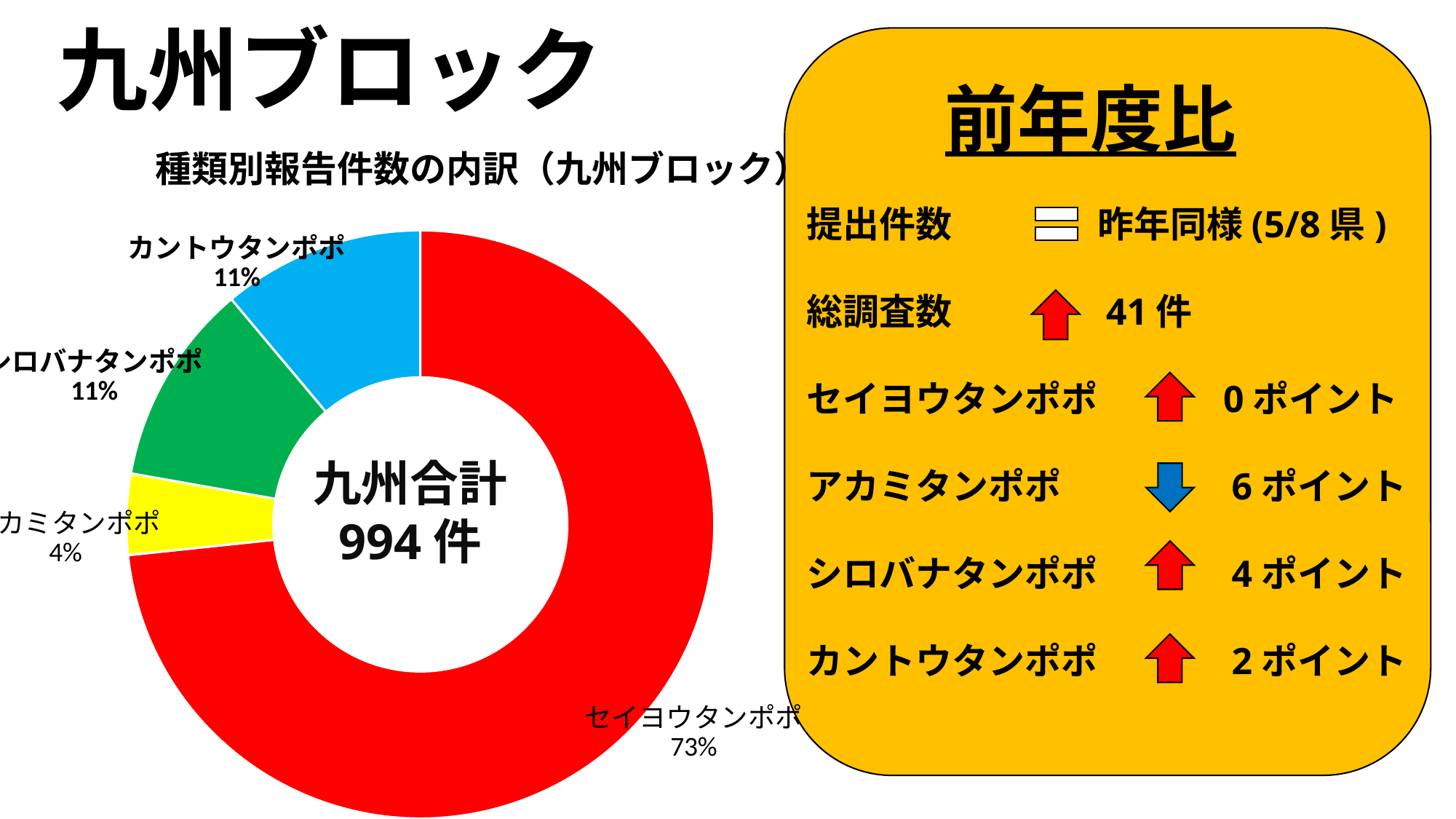
What is the title of the pie chart? 種類別報告件数の内訳（九州ブロック） What total number of cases is shown in the centre of the pie chart? 994件 Which category has the smallest slice of the pie? アカミタンポポ What percentage of the pie does セイヨウタンポポ account for? 73% Which is larger, the share for セイヨウタンポポ or the share for アカミタンポポ? セイヨウタンポポ What percentage is shown for カントウタンポポ? 11% What percentage is shown for シロバナタンポポ? 11% What kind of chart is shown on the slide? pie chart (donut) How many categories (slices) does the pie chart have? 4 What is the difference in percentage points between セイヨウタンポポ and カントウタンポポ? 62 percentage points Which category has the largest slice of the pie? セイヨウタンポポ What percentage is shown for アカミタンポポ? 4%